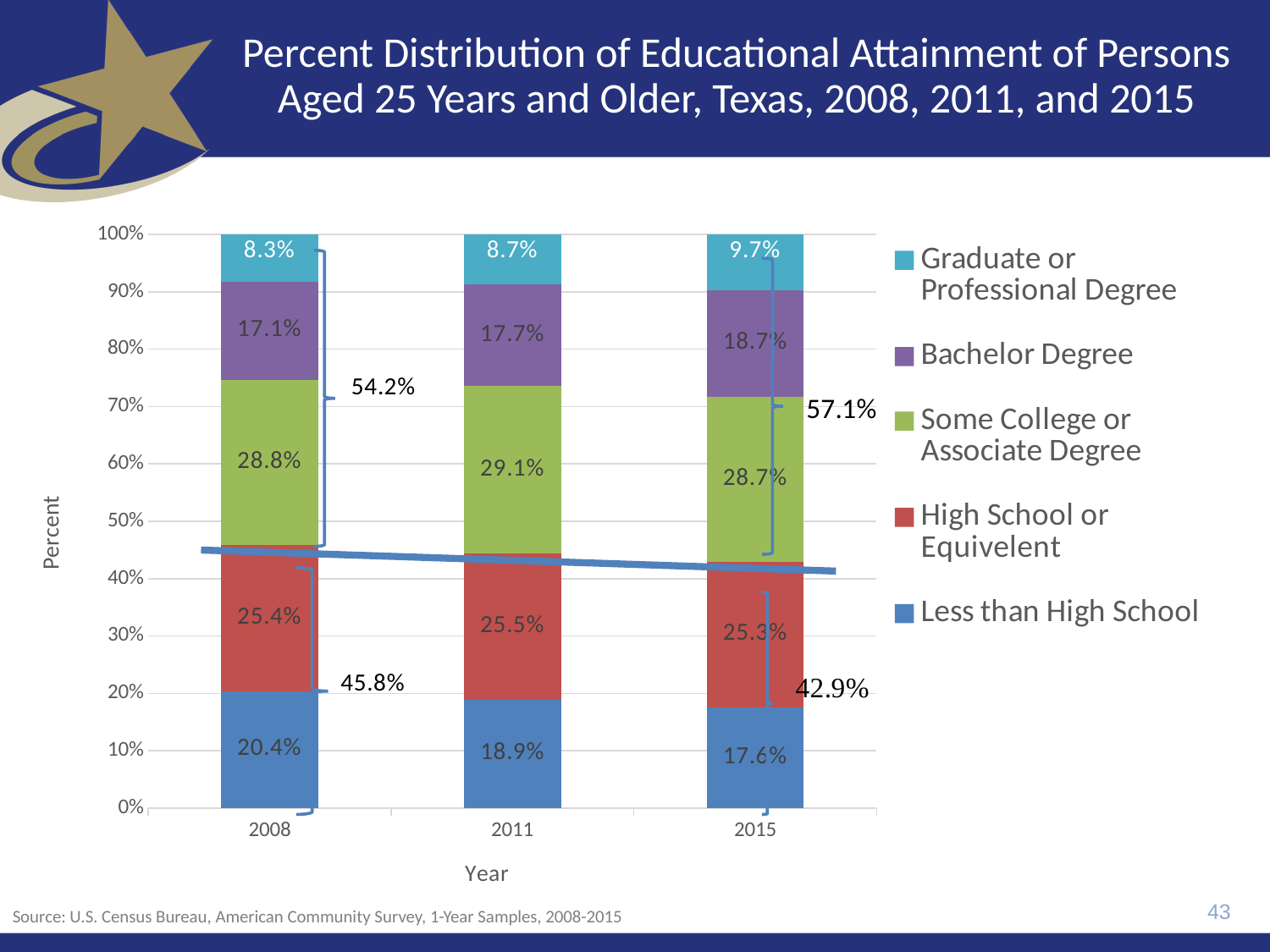
In which year is the Less than High School share the lowest? 2015 How many years are shown on the x axis? 3 In which year is the Graduate or Professional Degree share the highest? 2015 What is the value for Bachelor Degree in 2011? 17.7% What combined percentage is annotated for the bottom two segments (Less than High School and High School or Equivalent) in 2008? 45.8% What is the value for Graduate or Professional Degree in 2015? 9.7% Which year has the larger Some College or Associate Degree share, 2011 or 2015? 2011 How many series does the legend list? 5 Does the Less than High School share rise or fall from 2008 to 2015? Fall What percentage of persons aged 25 and older in Texas had Less than High School education in 2008? 20.4% What kind of chart is shown on the slide? Stacked bar chart By how many percentage points did the Less than High School share fall from 2008 to 2015? 2.8 percentage points